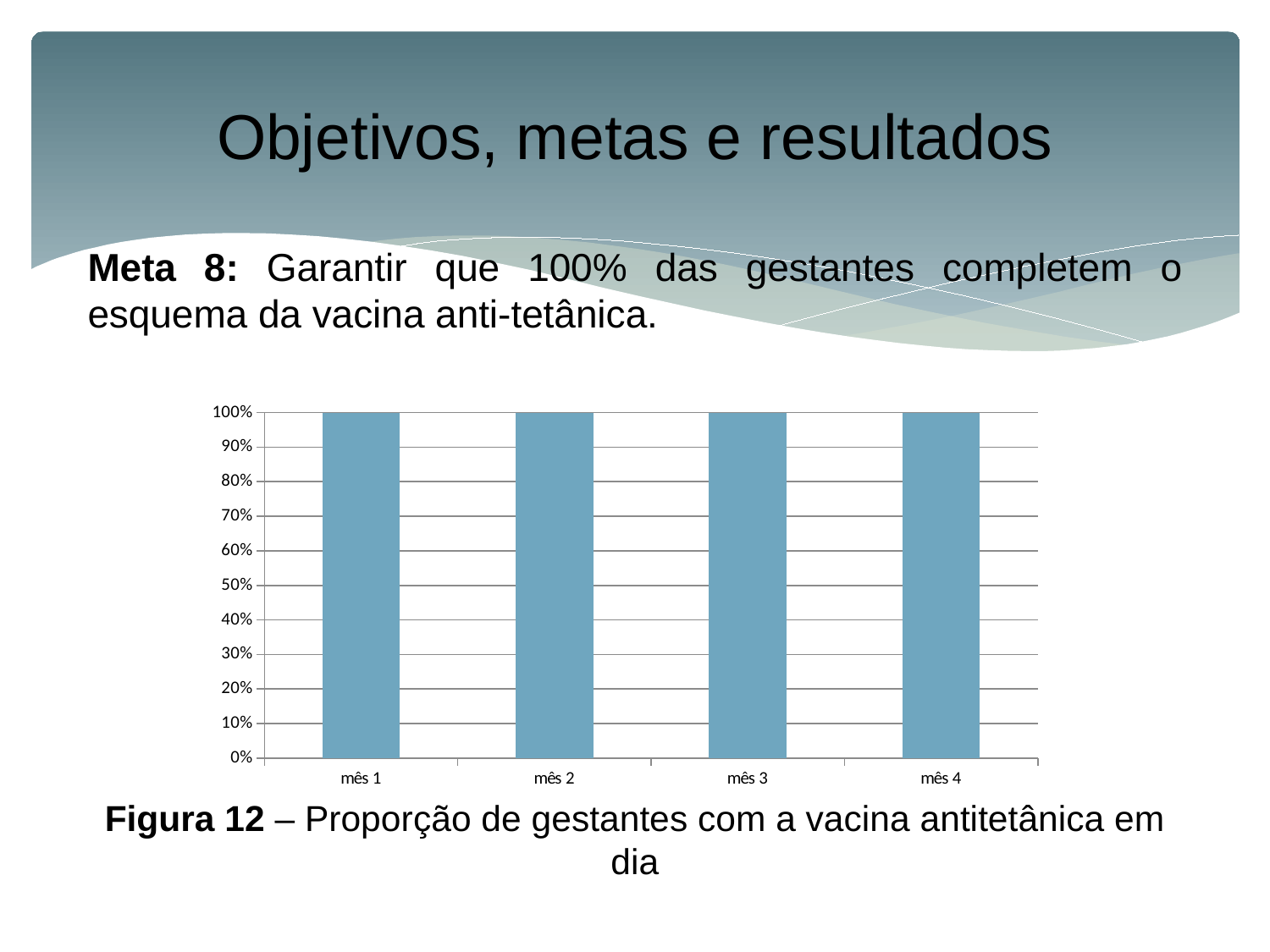
Is the value for mês 4 greater or less than 50%? greater What is the value for mês 4? 100% Do the values rise, fall or stay the same from mês 1 to mês 4? stay the same What is the highest value shown on the y axis? 100% How many categories are shown on the x axis? 4 What is the difference between the values for mês 1 and mês 4? 0% What is the value for mês 1? 100% Is the value for mês 2 greater or less than 90%? greater What kind of chart is shown on the slide? bar chart What is the figure number given in the caption below the chart? Figura 12 What is the value for mês 3? 100%